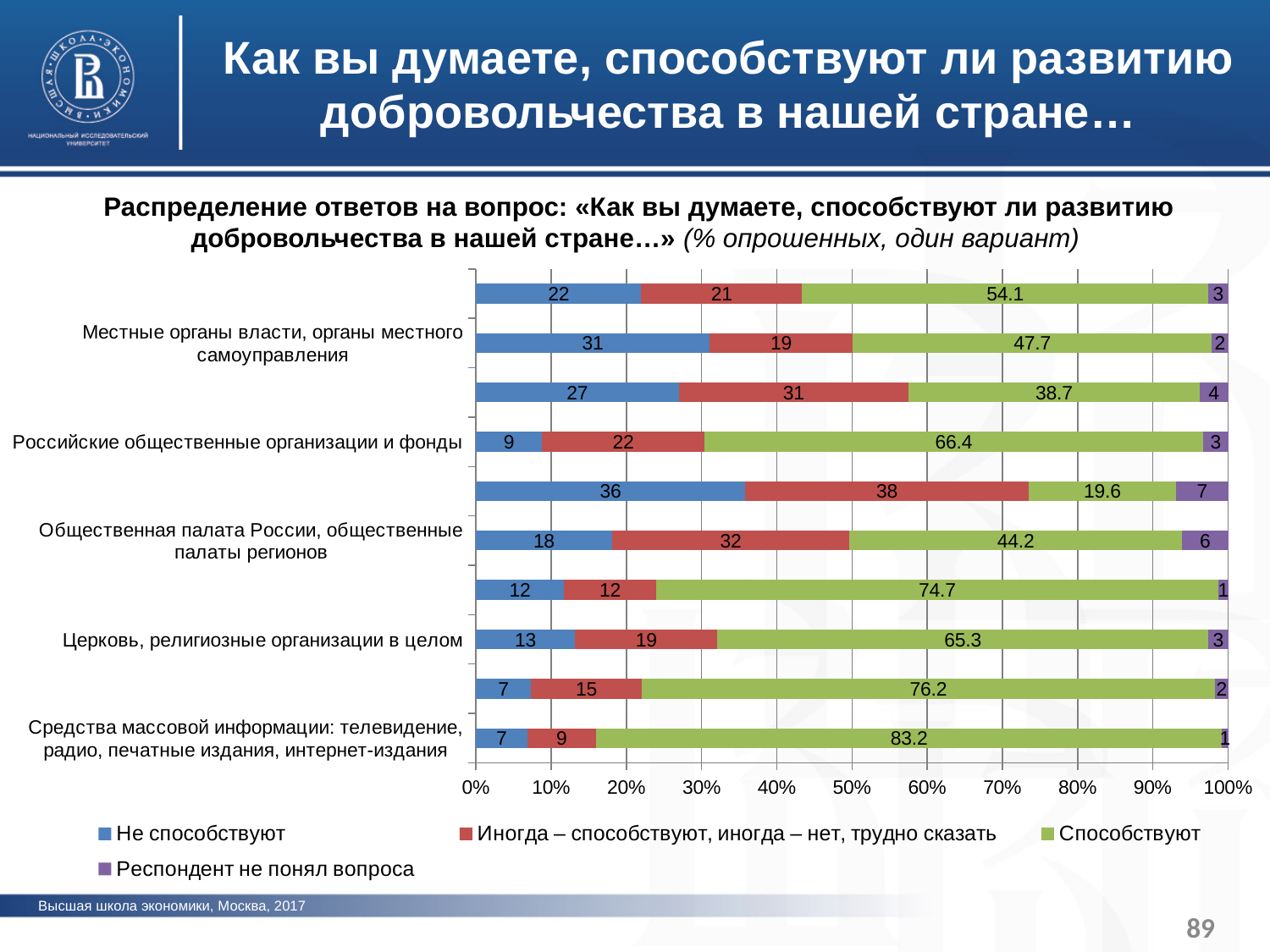
Which legend entry is shown in green? Способствуют What is the value for «Способствуют» for «Российские общественные организации и фонды»? 66.4 What is the value for «Респондент не понял вопроса» for «Церковь, религиозные организации в целом»? 3 What is the value for «Иногда – способствуют, иногда – нет, трудно сказать» for «Общественная палата России, общественные палаты регионов»? 32 What is the value for «Иногда – способствуют, иногда – нет, трудно сказать» for «Церковь, религиозные организации в целом»? 19 What is the value for «Способствуют» for «Средства массовой информации: телевидение, радио, печатные издания, интернет-издания»? 83.2 How many series does the legend list? 4 What is the value for «Не способствуют» for «Местные органы власти, органы местного самоуправления»? 31 Which category has the highest value for «Способствуют»? Средства массовой информации: телевидение, радио, печатные издания, интернет-издания Which is larger: the «Не способствуют» value for «Местные органы власти, органы местного самоуправления» or for «Российские общественные организации и фонды»? Местные органы власти, органы местного самоуправления What kind of chart is shown on the slide? Stacked bar chart What is the difference between the «Способствуют» values for «Церковь, религиозные организации в целом» and «Общественная палата России, общественные палаты регионов»? 21.1